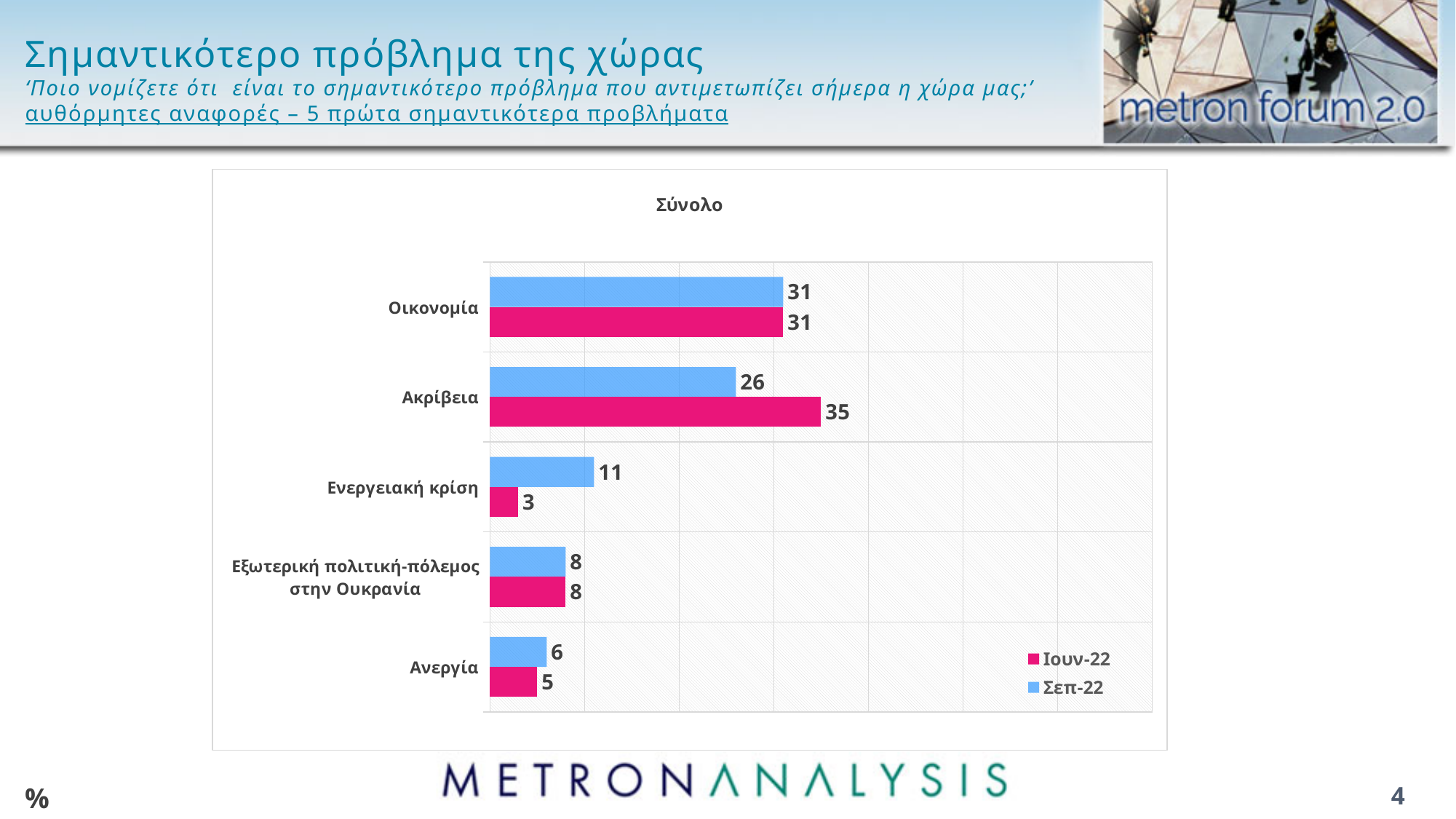
What is the value for Ανεργία in the Ιουν-22 series? 5 Which is larger for Ενεργειακή κρίση: the Ιουν-22 value or the Σεπ-22 value? Σεπ-22 Which category has the lowest value in the Σεπ-22 series? Ανεργία What is the value for Ενεργειακή κρίση in the Σεπ-22 series? 11 Which colour represents the Σεπ-22 series? blue Which category has the highest value in the Ιουν-22 series? Ακρίβεια What kind of chart is shown on the slide? bar chart How many series does the legend list? 2 What is the difference between the Ιουν-22 and Σεπ-22 values for Ακρίβεια? 9 How many categories are shown in the chart? 5 What is the value for Ακρίβεια in the Ιουν-22 series? 35 What is the title of the chart? Σύνολο